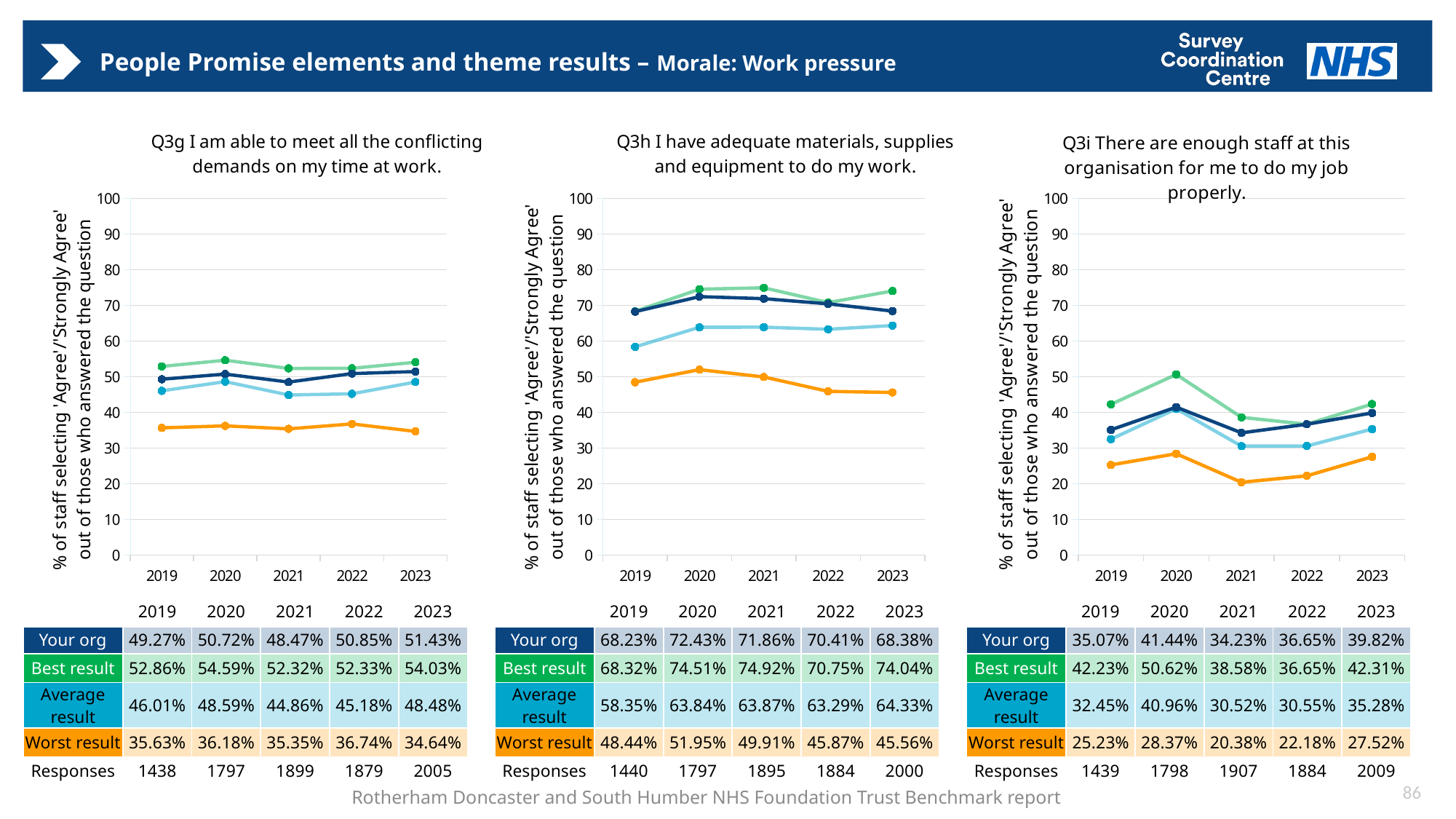
In the Q3h chart (middle), in which year is the 'Worst result' value lowest? 2023 In the Q3h chart (middle), which is larger for 2021: 'Your org' or 'Best result'? Best result What kind of chart is used for Q3i (right)? Line chart In the Q3g chart (left), what is the 'Your org' value for 2023? 51.43% In the Q3i chart (right), is the 'Worst result' value for 2021 greater or less than 30? less In the Q3h chart (middle), what is the 'Worst result' value for 2019? 48.44% How many years are shown on the x axis of the Q3g chart (left)? 5 In the Q3g chart (left), what is the difference between the 'Best result' and 'Your org' values for 2023? 2.60 percentage points In the Q3i chart (right), what is the difference between the 'Your org' and 'Average result' values for 2020? 0.48 percentage points How many series are plotted in the Q3h chart (middle)? 4 In the Q3i chart (right), in which year is the 'Your org' value highest? 2020 In the Q3i chart (right), what is the 'Best result' value for 2020? 50.62%